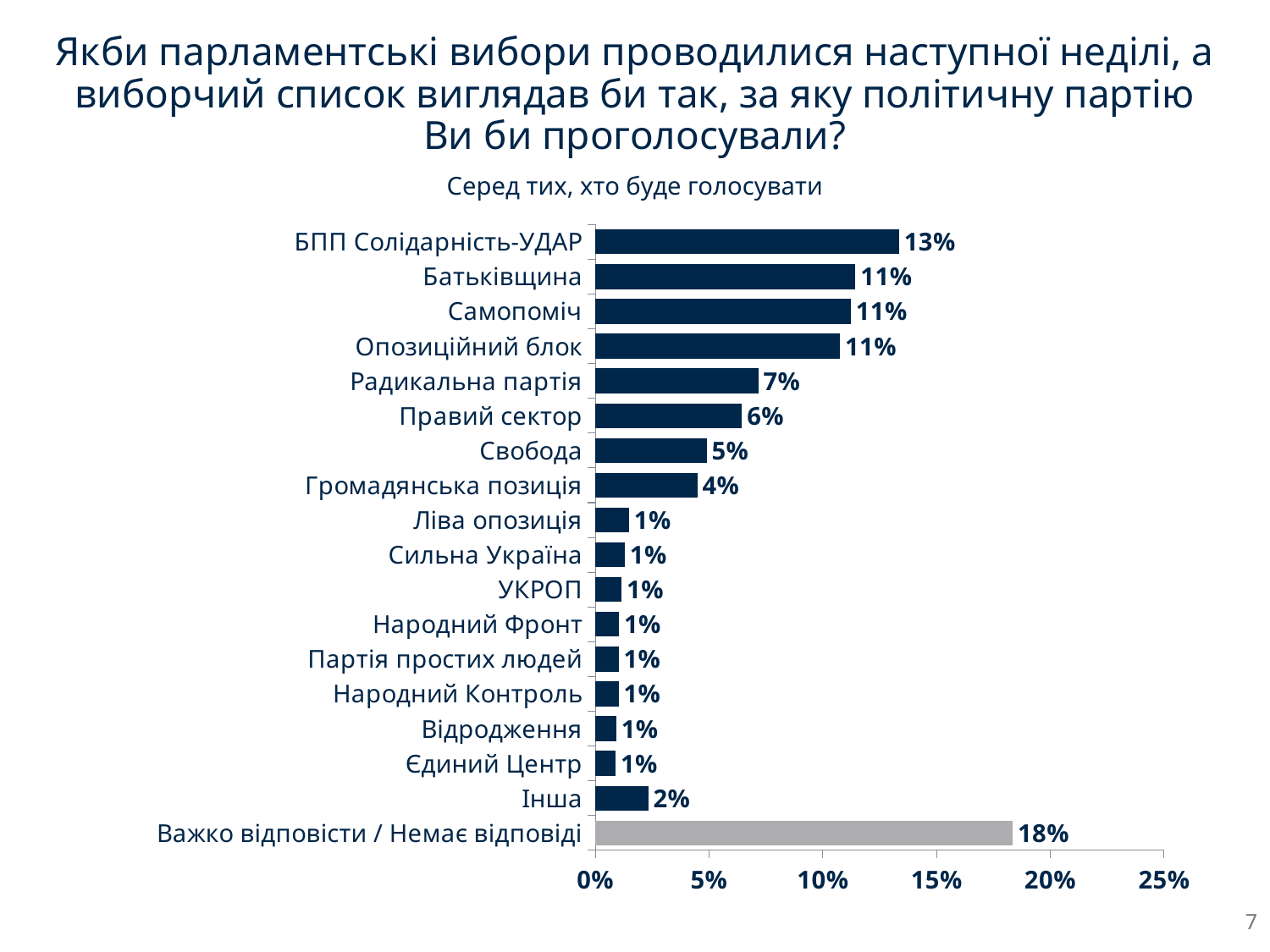
What percentage of respondents would vote for БПП Солідарність-УДАР? 13% What kind of chart is shown on the slide? Bar chart Is the value for Свобода greater or less than 10%? less Which political party has the highest share of votes in the chart? БПП Солідарність-УДАР What is the value shown for Громадянська позиція? 4% Which category has the longest bar in the chart? Важко відповісти / Немає відповіді What is the difference in percentage points between БПП Солідарність-УДАР and Радикальна партія? 6 percentage points What colour is the bar for Важко відповісти / Немає відповіді? Grey What is the value shown for Важко відповісти / Немає відповіді? 18% What is the value shown for Радикальна партія? 7% Which has a larger value, Правий сектор or Свобода? Правий сектор How many categories are shown in the chart? 18